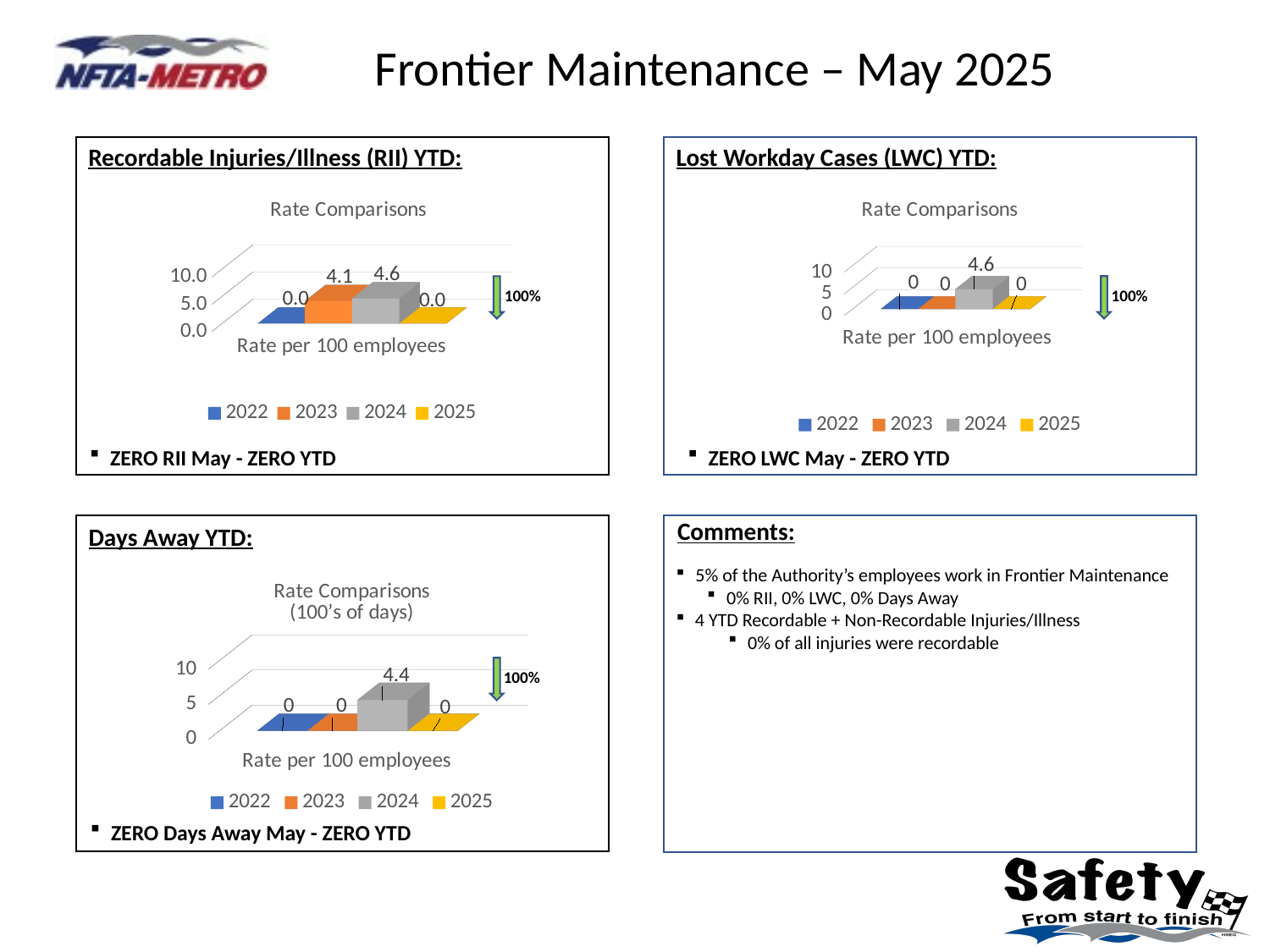
In the Recordable Injuries/Illness (RII) YTD chart, what is the value for 2023? 4.1 What is the title of the chart in the Days Away YTD box? Rate Comparisons (100's of days) In the Lost Workday Cases (LWC) YTD chart, is the value for 2024 greater or less than 5? less How many series does the legend list in the Days Away YTD chart? 4 In the Recordable Injuries/Illness (RII) YTD chart, what is the value for 2024? 4.6 In the Days Away YTD chart, what is the value for 2024? 4.4 In the Recordable Injuries/Illness (RII) YTD chart, which year has the highest value? 2024 In the Days Away YTD chart, which is larger, the value for 2024 or the value for 2023? 2024 In the Lost Workday Cases (LWC) YTD chart, what is the value for 2025? 0 In the Lost Workday Cases (LWC) YTD chart, what is the value for 2024? 4.6 What kind of chart is the Recordable Injuries/Illness (RII) YTD chart? Bar chart In the Recordable Injuries/Illness (RII) YTD chart, what is the difference between the 2024 and 2023 values? 0.5